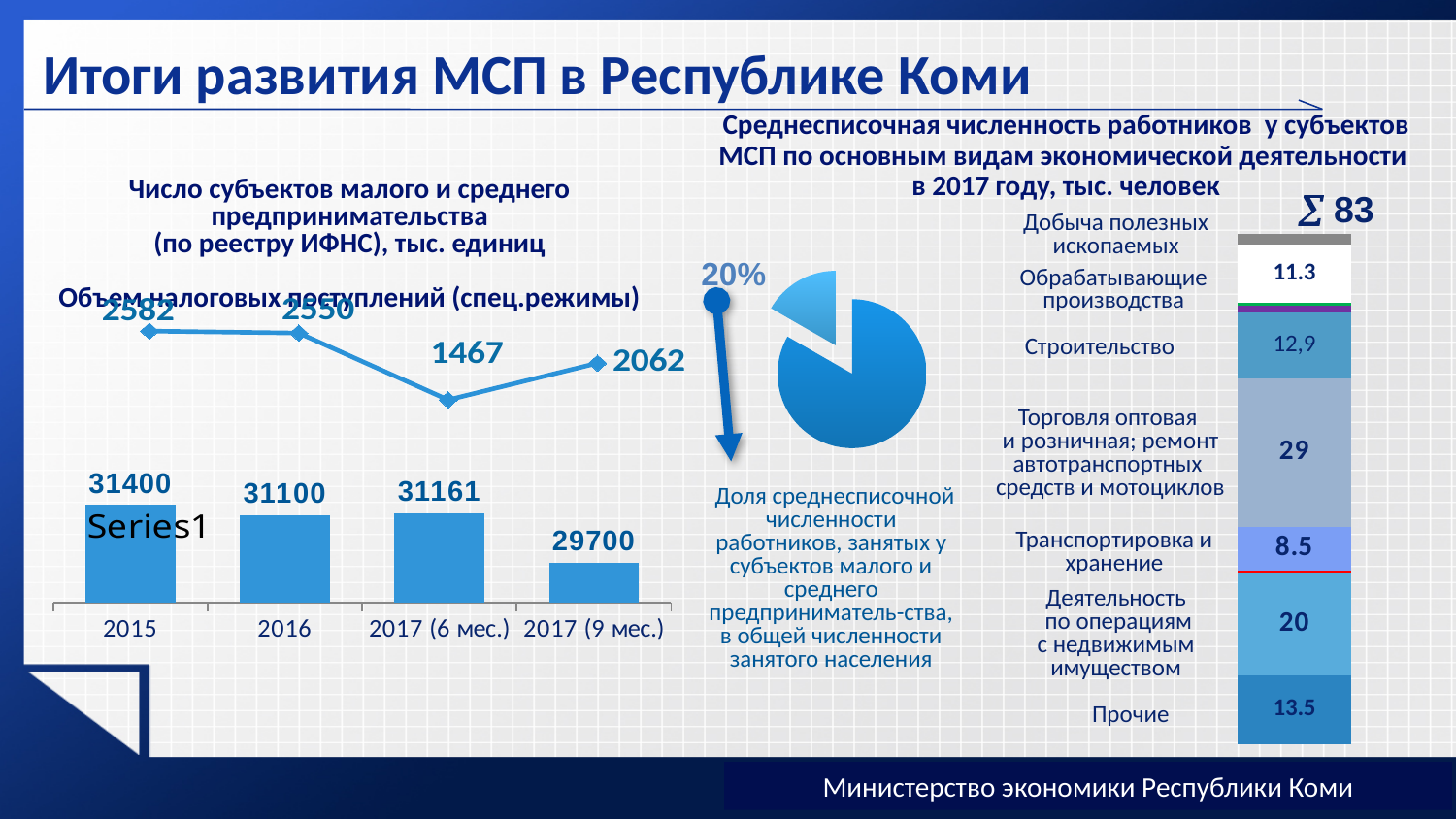
On the bar chart 'Число субъектов малого и среднего предпринимательства', how many periods are shown on the x axis? 4 On the stacked bar chart 'Среднесписочная численность работников у субъектов МСП', what is the total shown above the bar? 83 What kind of chart is used for 'Число субъектов малого и среднего предпринимательства'? bar chart On the bar chart 'Число субъектов малого и среднего предпринимательства', which period has the highest value? 2015 On the line chart 'Объем налоговых поступлений (спец.режимы)', what is the value for 2017 (6 мес.)? 1467 On the bar chart 'Число субъектов малого и среднего предпринимательства', what is the value for 2015? 31400 On the bar chart 'Число субъектов малого и среднего предпринимательства', which period has the lowest value? 2017 (9 мес.) On the stacked bar chart 'Среднесписочная численность работников у субъектов МСП', what is the value for 'Торговля оптовая и розничная; ремонт автотранспортных средств и мотоциклов'? 29 On the bar chart 'Число субъектов малого и среднего предпринимательства', what is the value for 2017 (9 мес.)? 29700 On the pie chart in the middle of the slide, what share is shown for the highlighted slice? 20% On the bar chart 'Число субъектов малого и среднего предпринимательства', what is the difference between the 2015 value and the 2017 (9 мес.) value? 1700 On the line chart 'Объем налоговых поступлений (спец.режимы)', which is larger: the value for 2015 or the value for 2017 (9 мес.)? 2015